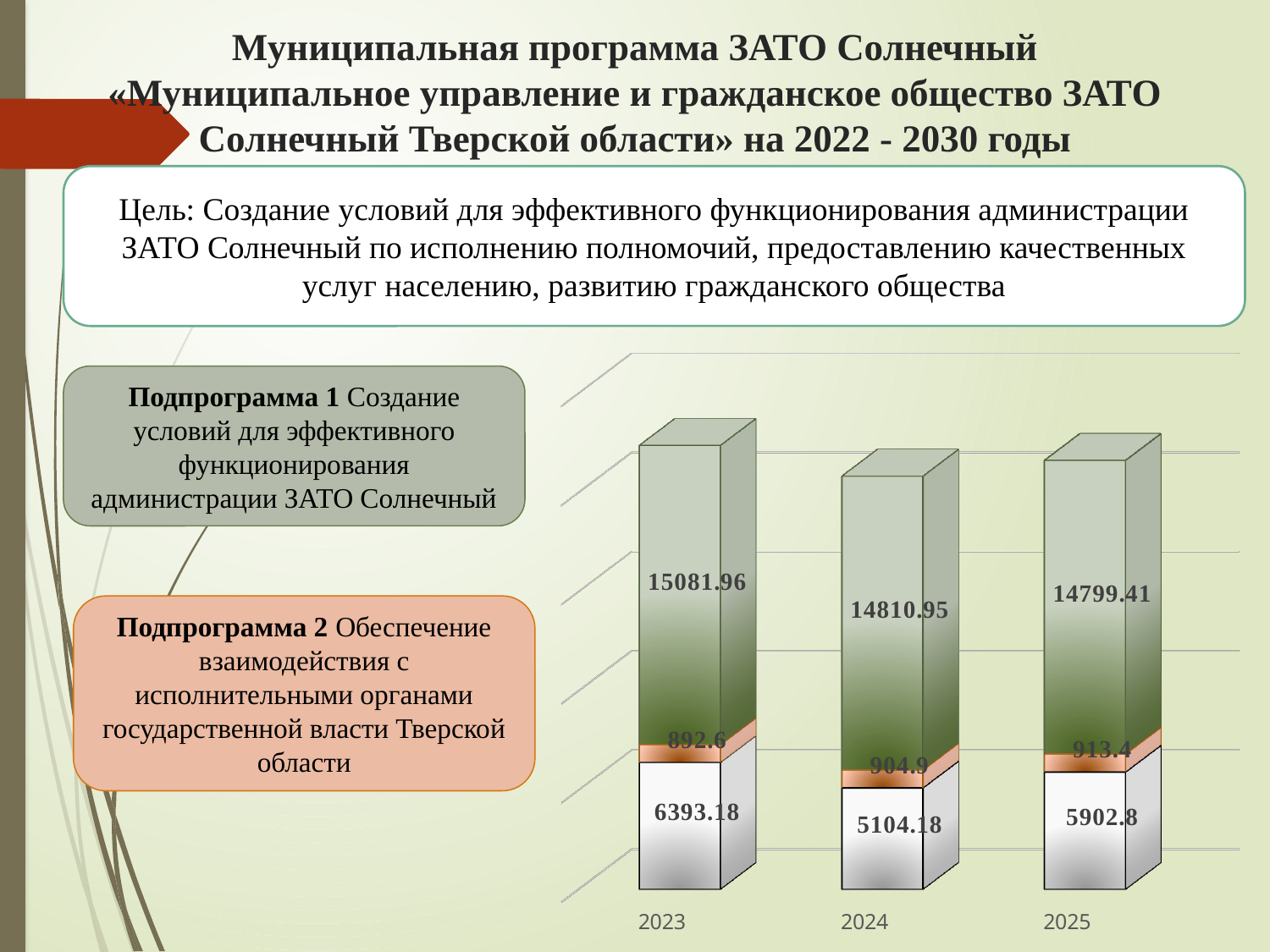
What kind of chart is shown on the slide? Stacked bar chart What is the total of the stacked bar for 2023? 22367.74 Which year has the highest value for the top green segment? 2023 What is the difference between the bottom segment values for 2023 and 2024? 1289 What is the value of the bottom segment of the bar for 2024? 5104.18 What is the value of the middle orange segment of the bar for 2025? 913.4 How many years (categories) are shown on the x axis of the chart? 3 What is the value of the top green segment of the bar for 2023? 15081.96 Do the values of the top green segment rise or fall from 2023 to 2025? Fall Which year has the lowest value for the bottom segment? 2024 Which is larger: the middle orange segment for 2023 or for 2025? 2025 What is the difference between the top green segment values for 2023 and 2024? 271.01